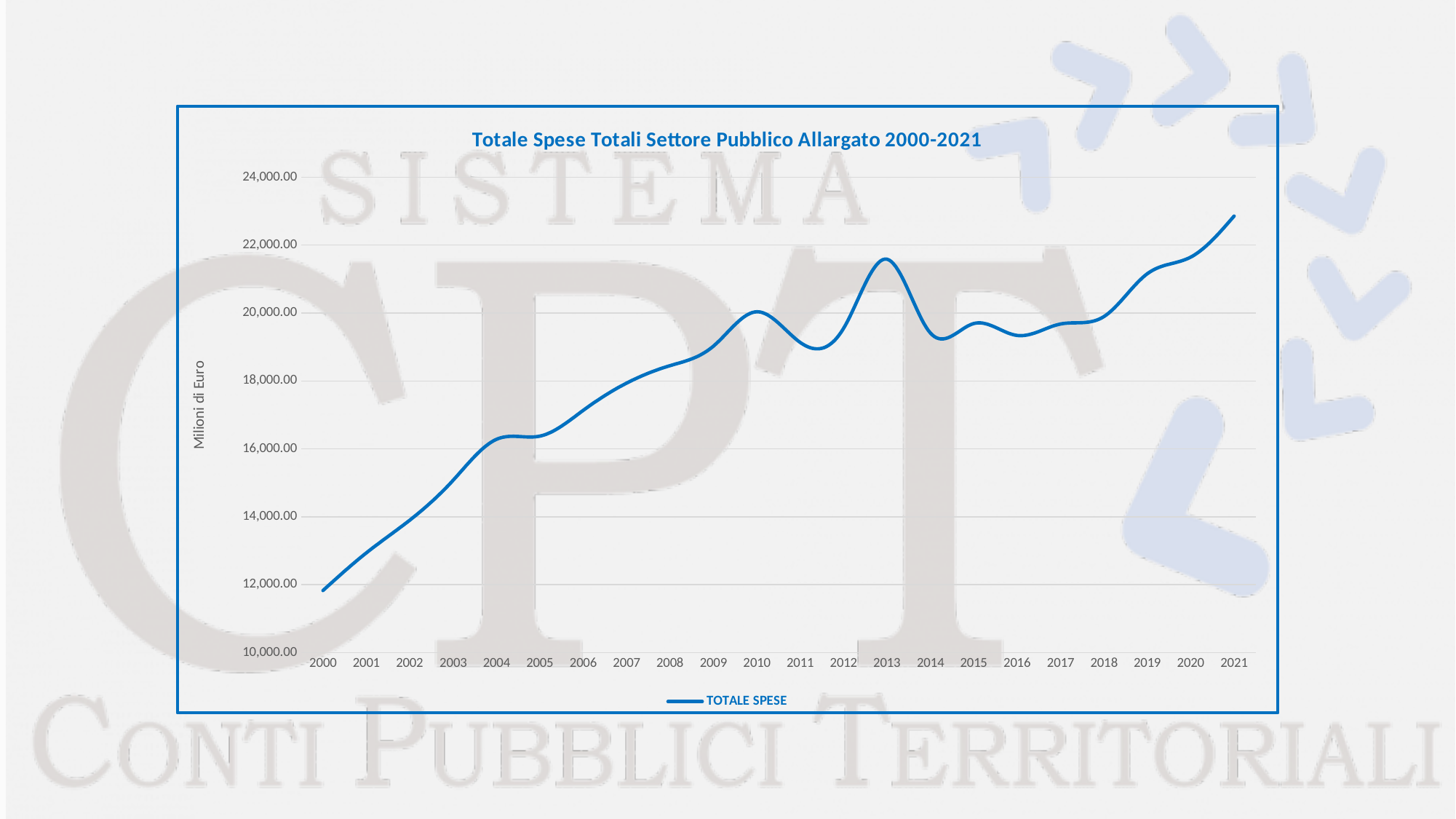
Is the value for 2021 greater or less than 22,000.00? greater Is the value for 2000 greater or less than 12,000.00? less Which year has the highest value for TOTALE SPESE? 2021 Which year has the larger value, 2013 or 2016? 2013 How many years are plotted along the x axis? 22 How many series does the legend list? 1 What is the title of the chart? Totale Spese Totali Settore Pubblico Allargato 2000-2021 What kind of chart is shown on the slide? Line chart Overall, do the values rise or fall from 2000 to 2021? Rise Is the value for 2002 greater or less than 14,000.00? less Which year has the lowest value for TOTALE SPESE? 2000